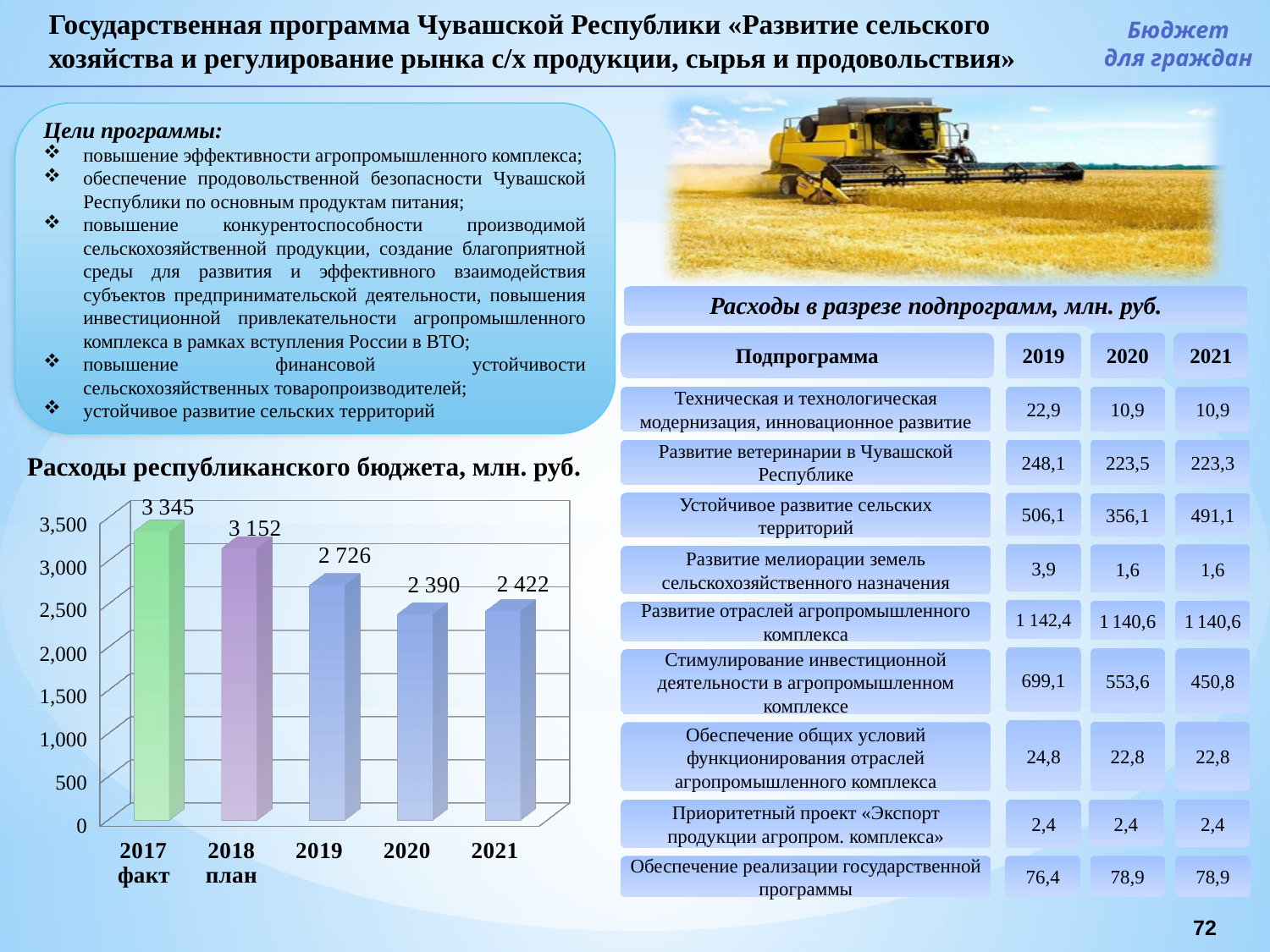
What is the value for 2017 факт in the chart 'Расходы республиканского бюджета, млн. руб.'? 3 345 What is the difference between the values for 2019 and 2020 in the chart 'Расходы республиканского бюджета, млн. руб.'? 336 Which year has the highest value in the chart 'Расходы республиканского бюджета, млн. руб.'? 2017 факт Which year has the lowest value in the chart 'Расходы республиканского бюджета, млн. руб.'? 2020 What type of chart is 'Расходы республиканского бюджета, млн. руб.'? bar chart In the chart 'Расходы республиканского бюджета, млн. руб.', do the values rise or fall from 2017 факт to 2020? fall What is the difference between the values for 2017 факт and 2018 план in the chart 'Расходы республиканского бюджета, млн. руб.'? 193 How many bars are shown in the chart 'Расходы республиканского бюджета, млн. руб.'? 5 What is the value for 2021 in the chart 'Расходы республиканского бюджета, млн. руб.'? 2 422 In the chart 'Расходы республиканского бюджета, млн. руб.', which is larger: the value for 2020 or the value for 2021? 2021 What is the value for 2019 in the chart 'Расходы республиканского бюджета, млн. руб.'? 2 726 Is the value for 2019 in the chart 'Расходы республиканского бюджета, млн. руб.' greater or less than 2,500? greater